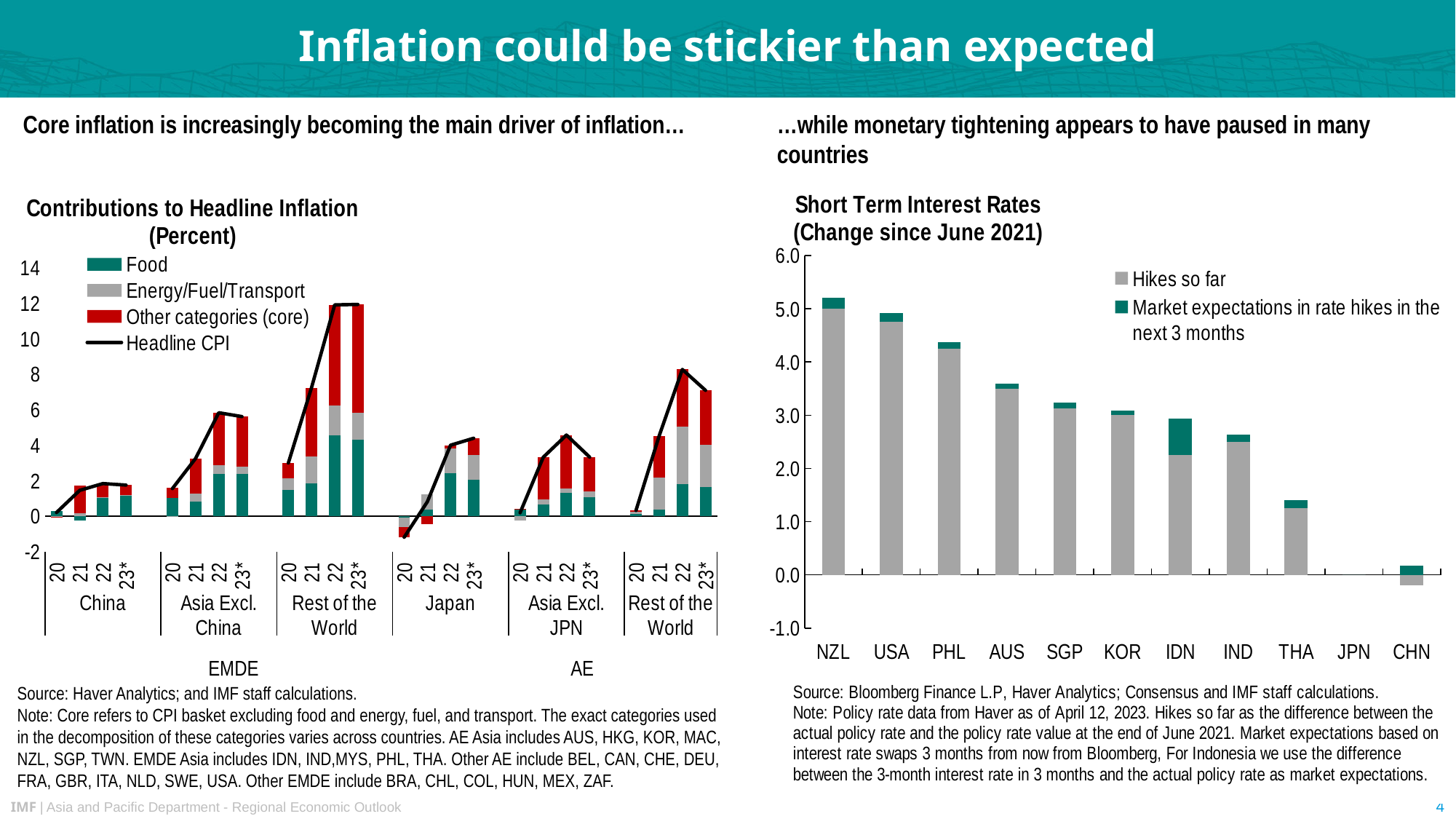
In the 'Contributions to Headline Inflation (Percent)' chart, is the Headline CPI value for Rest of the World (EMDE) in 2022 greater or less than 10? greater In the 'Short Term Interest Rates' chart, which country has the highest total bar? NZL How many entries does the legend of the 'Contributions to Headline Inflation (Percent)' chart list? 4 How many countries are shown on the x axis of the 'Short Term Interest Rates' chart? 11 What kind of chart is the 'Short Term Interest Rates (Change since June 2021)' chart? bar chart In the 'Short Term Interest Rates' chart, is the total value for THA greater or less than 1.0? greater In the 'Short Term Interest Rates' chart, which country has the lowest value? CHN In the 'Contributions to Headline Inflation (Percent)' chart, which colour represents 'Other categories (core)'? red How many series does the legend of the 'Short Term Interest Rates' chart list? 2 In the 'Short Term Interest Rates' chart, which is larger, the total bar for PHL or the total bar for AUS? PHL